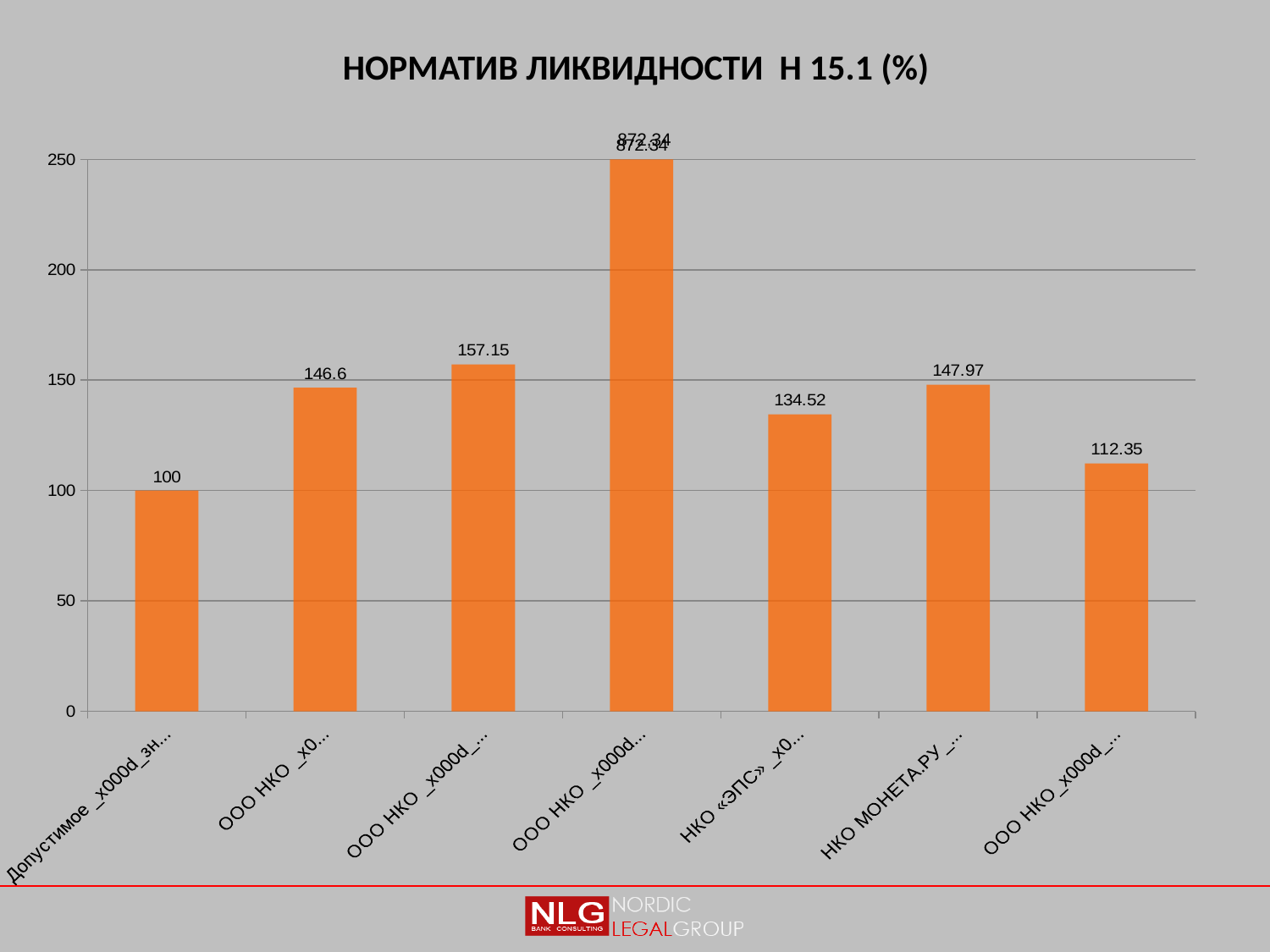
What is the lowest value shown in the chart? 100 What is the value of the first (leftmost) bar, labelled Допустимое? 100 What is the title of the chart? НОРМАТИВ ЛИКВИДНОСТИ Н 15.1 (%) Is the value for НКО «ЭПС» greater or less than 150? less How many bars are plotted in the chart? 7 What is the value for НКО «ЭПС»? 134.52 What kind of chart is shown on the slide? bar chart What is the difference between the values for НКО МОНЕТА.РУ and НКО «ЭПС»? 13.45 What is the value of the rightmost bar? 112.35 What is the highest value shown in the chart? 872.34 What is the value for НКО МОНЕТА.РУ? 147.97 Which is larger, the value for НКО «ЭПС» or the value for НКО МОНЕТА.РУ? НКО МОНЕТА.РУ